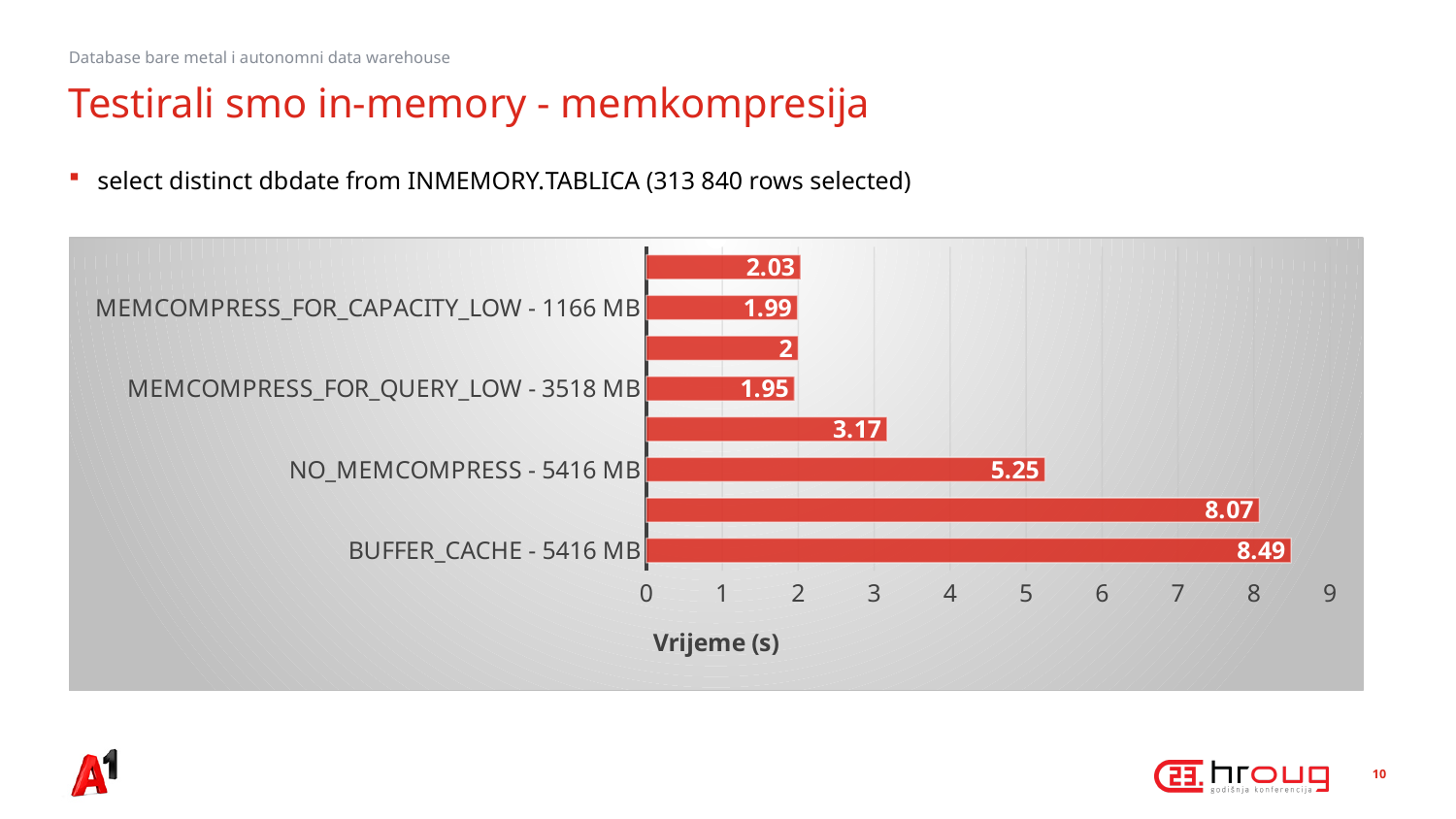
Which category has longer bars, BUFFER_CACHE - 5416 MB or NO_MEMCOMPRESS - 5416 MB? BUFFER_CACHE - 5416 MB What is the lowest value shown in the chart? 1.95 Is the value of the longest bar for BUFFER_CACHE - 5416 MB greater or less than 8? greater What is the title of the horizontal axis of the chart? Vrijeme (s) What is the highest value shown in the chart? 8.49 What is the value of the longer bar for BUFFER_CACHE - 5416 MB? 8.49 How many category labels are shown on the vertical axis of the chart? 4 What kind of chart is shown on the slide? bar chart How many bars are plotted in the chart? 8